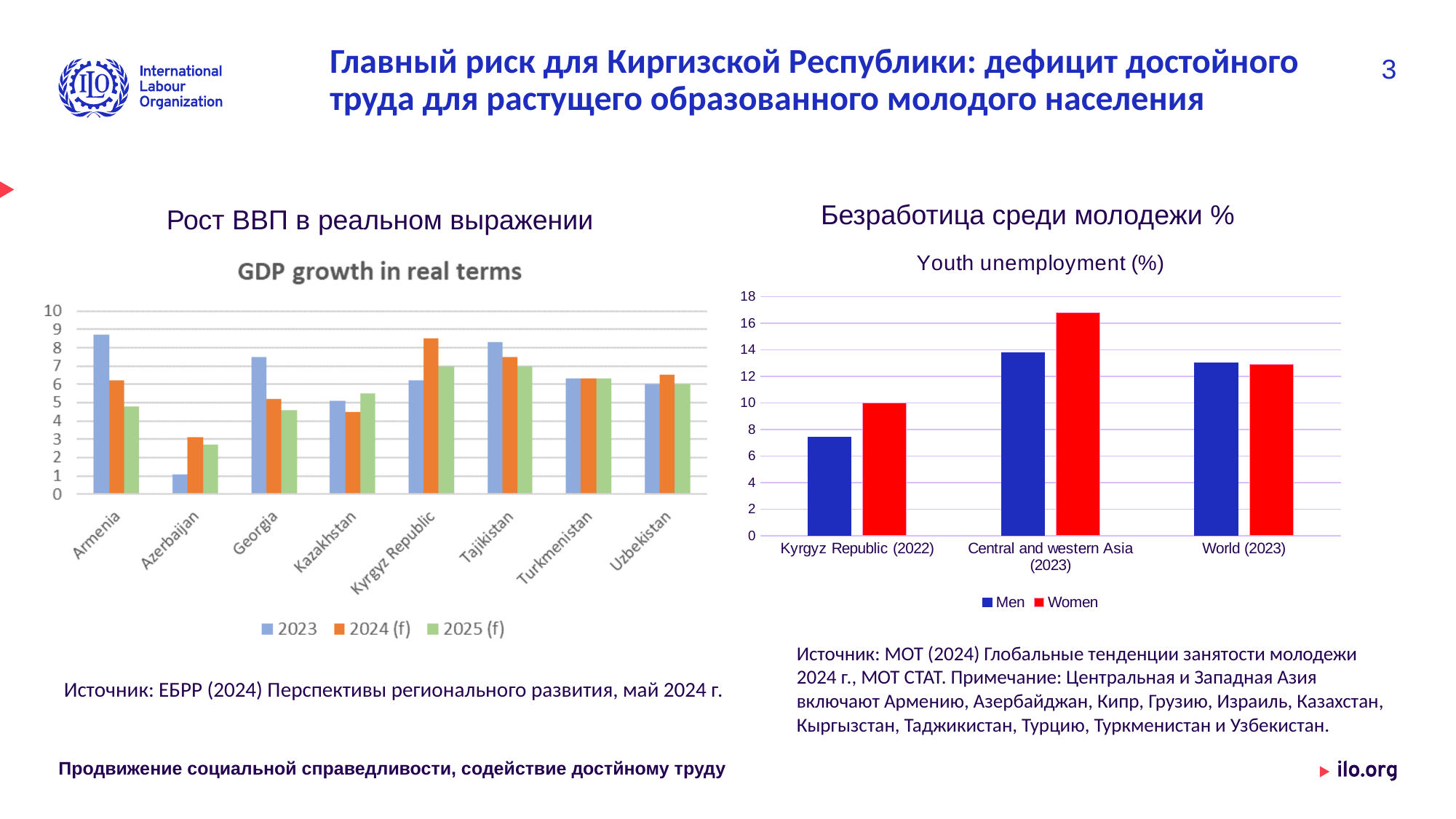
What kind of chart is the "GDP growth in real terms" chart? bar chart In the "GDP growth in real terms" chart, which is larger for the Kyrgyz Republic: the 2023 value or the 2024 (f) value? 2024 (f) In the "Youth unemployment (%)" chart, is the value for Men in Central and western Asia (2023) greater or less than 12? greater How many countries are shown on the x axis of the "GDP growth in real terms" chart? 8 How many series does the legend of the "GDP growth in real terms" chart list? 3 In the "GDP growth in real terms" chart, is the 2024 (f) value for Kazakhstan greater or less than 5? less In the "Youth unemployment (%)" chart, which bar is the lowest? Men, Kyrgyz Republic (2022) In the "GDP growth in real terms" chart, which is larger for Armenia: the 2023 value or the 2025 (f) value? 2023 In the "Youth unemployment (%)" chart, which bar is the highest? Women, Central and western Asia (2023) In the "GDP growth in real terms" chart, is the 2023 value for Armenia greater or less than 8? greater In the "GDP growth in real terms" chart, which country has the lowest 2023 value? Azerbaijan What are the two legend entries of the "Youth unemployment (%)" chart? Men and Women